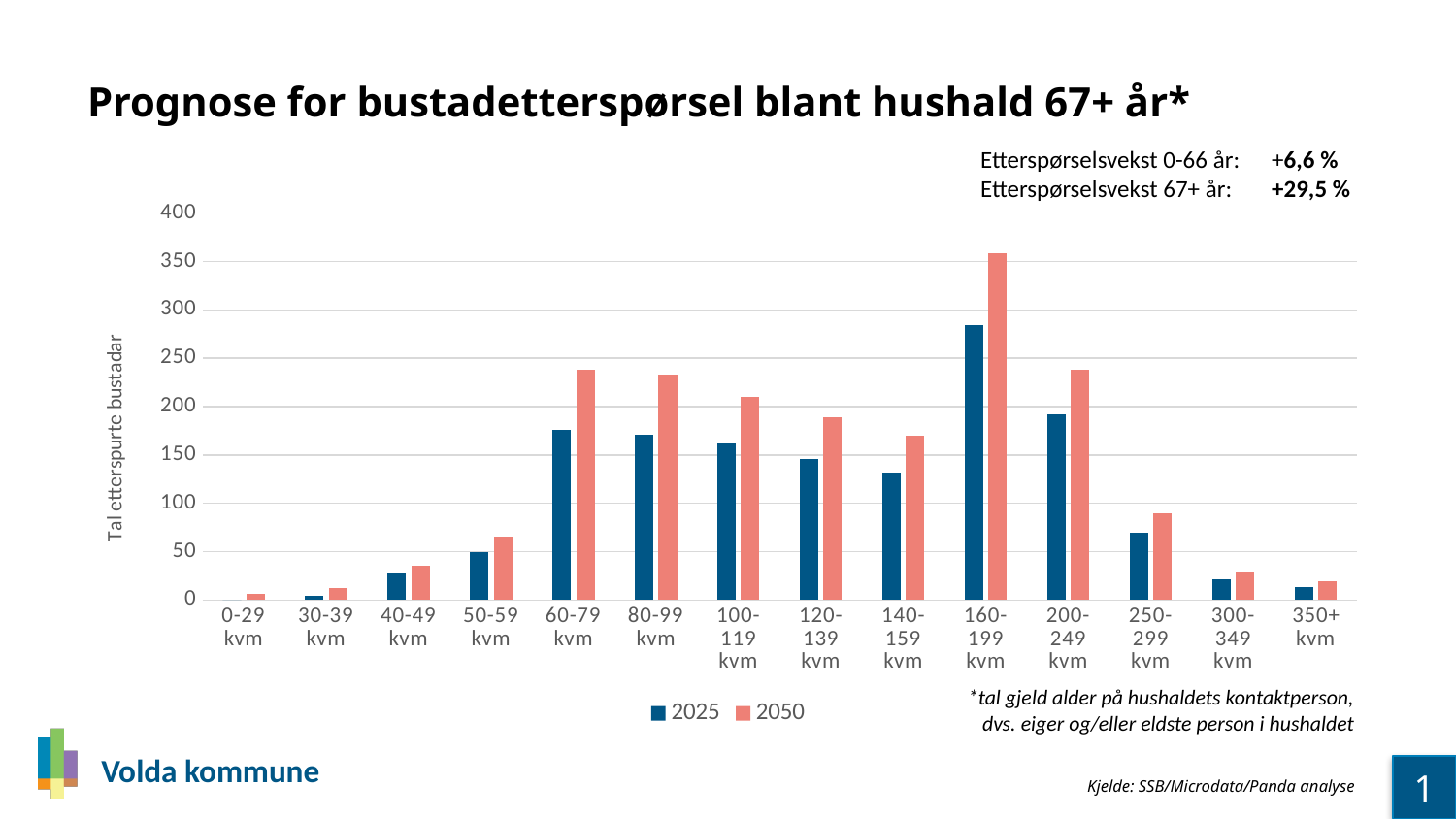
How many size categories are shown on the x axis? 14 Is the 2025 value for 160-199 kvm greater or less than 300? less What is the title of the chart? Prognose for bustadetterspørsel blant hushald 67+ år* Is the 2050 value for 250-299 kvm greater or less than 100? less For 60-79 kvm, which series has the larger value, 2025 or 2050? 2050 Is the 2050 value for 160-199 kvm greater or less than 300? greater Which size category has the lowest value for the 2025 series? 0-29 kvm How many series does the legend list? 2 What kind of chart is shown on the slide? Bar chart Which size category has the highest value for the 2025 series? 160-199 kvm Which size category has the highest value for the 2050 series? 160-199 kvm